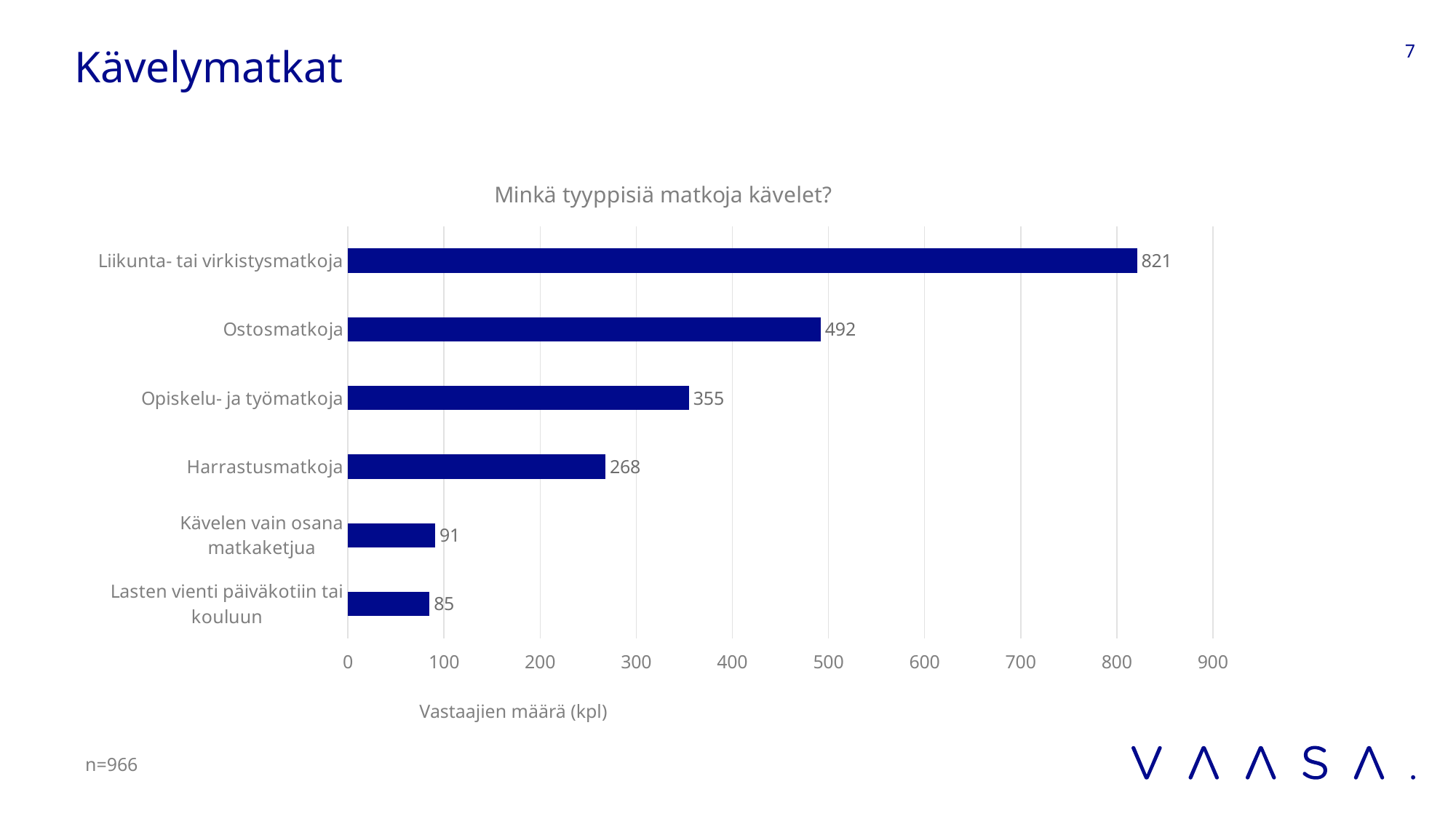
What is the value for Ostosmatkoja? 492 What kind of chart is shown on the slide? Bar chart What is the value for Lasten vienti päiväkotiin tai kouluun? 85 What is the difference between the values for Ostosmatkoja and Opiskelu- ja työmatkoja? 137 How many categories are shown in the chart? 6 What is the title of the chart? Minkä tyyppisiä matkoja kävelet? Which category has the highest value? Liikunta- tai virkistysmatkoja What is the value for Liikunta- tai virkistysmatkoja? 821 Which category has the lowest value? Lasten vienti päiväkotiin tai kouluun What is the value for Harrastusmatkoja? 268 Which is larger, the value for Harrastusmatkoja or the value for Kävelen vain osana matkaketjua? Harrastusmatkoja Is the value for Opiskelu- ja työmatkoja greater or less than 300? greater